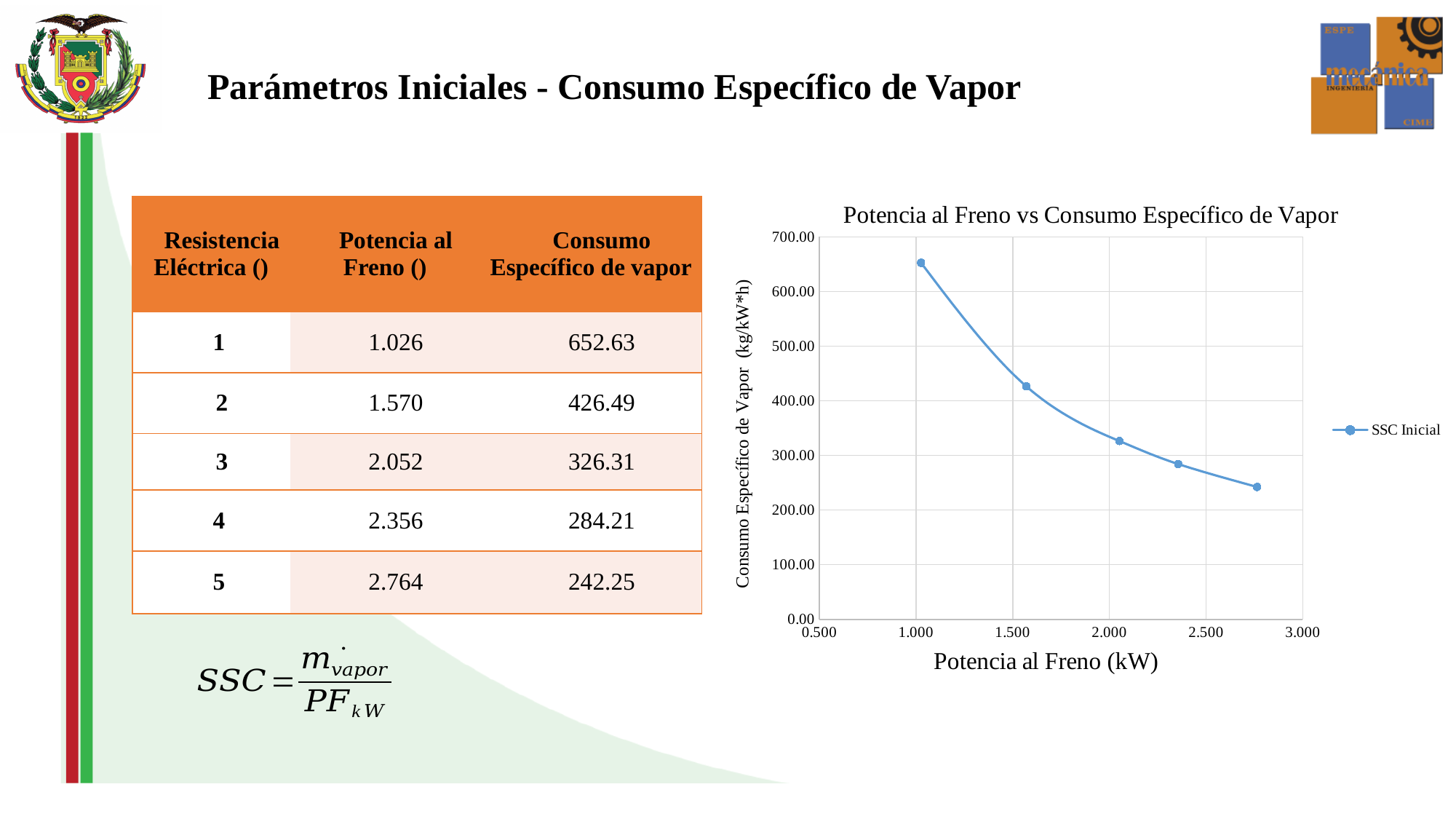
According to the table on the slide, what is the Potencia al Freno for Resistencia Eléctrica 5? 2.764 Is the Consumo Específico de Vapor at the first plotted point (Potencia al Freno about 1.0 kW) greater or less than 600.00? greater Does the Consumo Específico de Vapor rise or fall as Potencia al Freno increases along the x axis? fall Is the Consumo Específico de Vapor at the point near Potencia al Freno 2.05 kW greater or less than 400.00? less According to the table on the slide, what is the Consumo Específico de vapor for Resistencia Eléctrica 1? 652.63 What is the title of the chart? Potencia al Freno vs Consumo Específico de Vapor What is the name of the series shown in the chart legend? SSC Inicial Which plotted point has the highest Consumo Específico de Vapor: the one at the lowest Potencia al Freno or the one at the highest Potencia al Freno? the one at the lowest Potencia al Freno How many series does the chart legend list? 1 How many data points are plotted on the chart? 5 What kind of chart is shown on the slide? line chart Is the Consumo Específico de Vapor at the last plotted point (Potencia al Freno about 2.75 kW) greater or less than 300.00? less